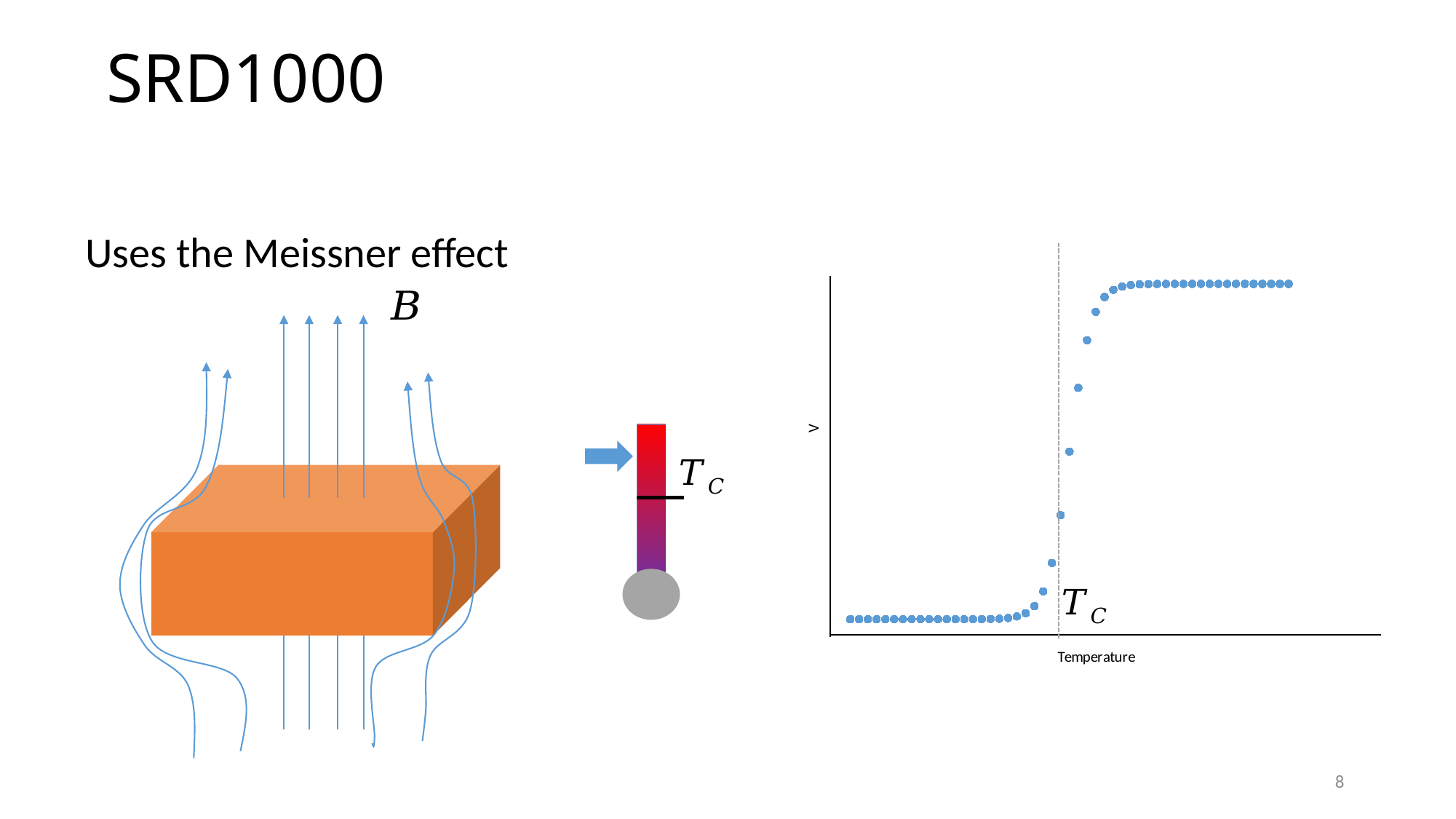
What is the label on the x axis of the chart? Temperature Are the plotted values at temperatures above T_C higher or lower than those below T_C? higher What kind of chart is shown on the right of the slide? scatter chart Do the plotted values rise or fall as temperature increases along the x axis? rise What does the dashed vertical line on the chart mark? T_C